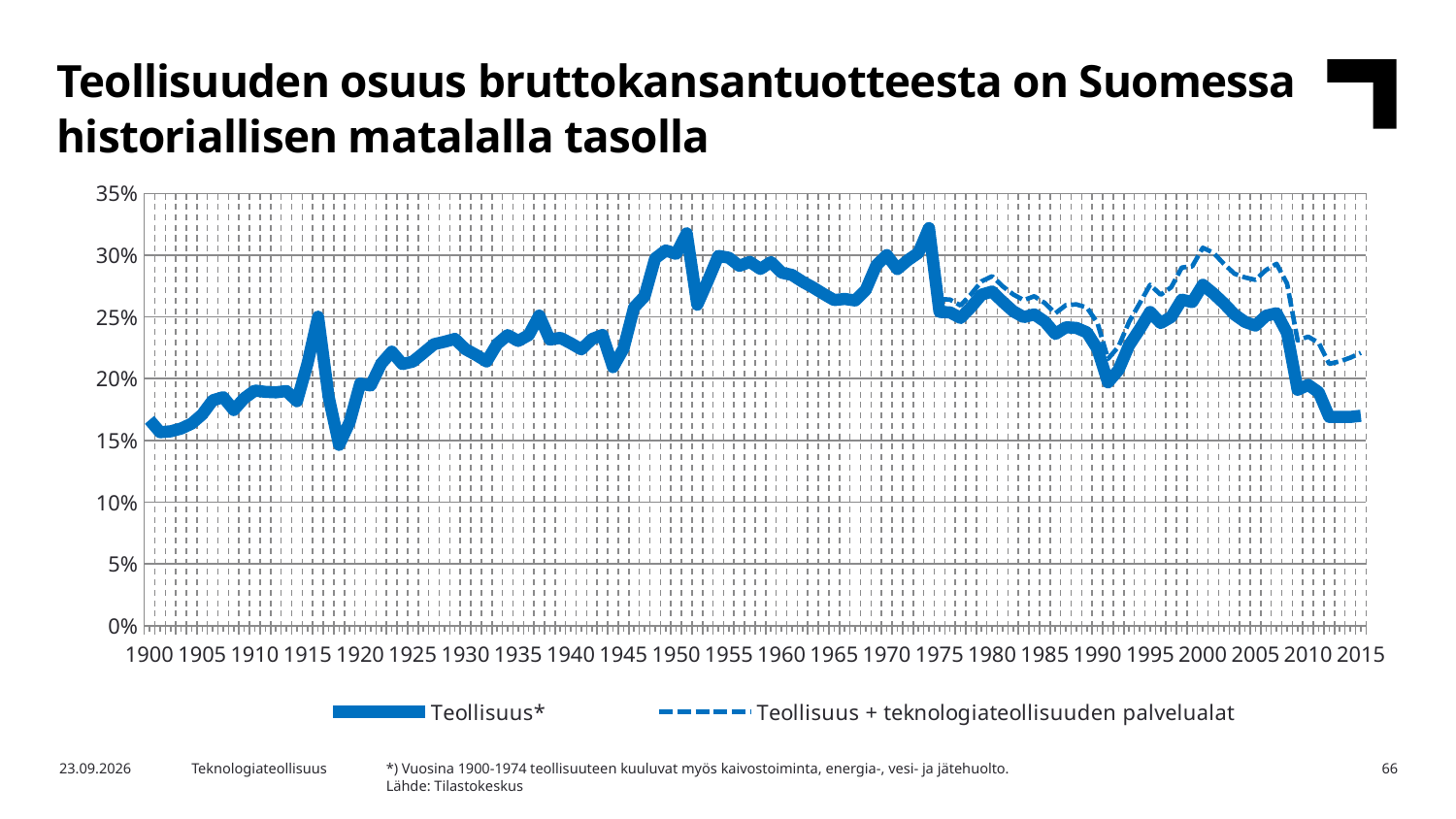
Is the value for Teollisuus* in 1930 greater or less than 20%? greater Is the value for Teollisuus* in 2015 greater or less than 20%? less Which series is drawn with a dashed line? Teollisuus + teknologiateollisuuden palvelualat In 2015, which series has the higher value: Teollisuus* or Teollisuus + teknologiateollisuuden palvelualat? Teollisuus + teknologiateollisuuden palvelualat What is the highest value shown on the vertical axis? 35% Is the value for Teollisuus + teknologiateollisuuden palvelualat in 2005 greater or less than 25%? greater How many series does the legend list? 2 Does the Teollisuus* line rise or fall between 2005 and 2015? fall What kind of chart is shown on the slide? line chart